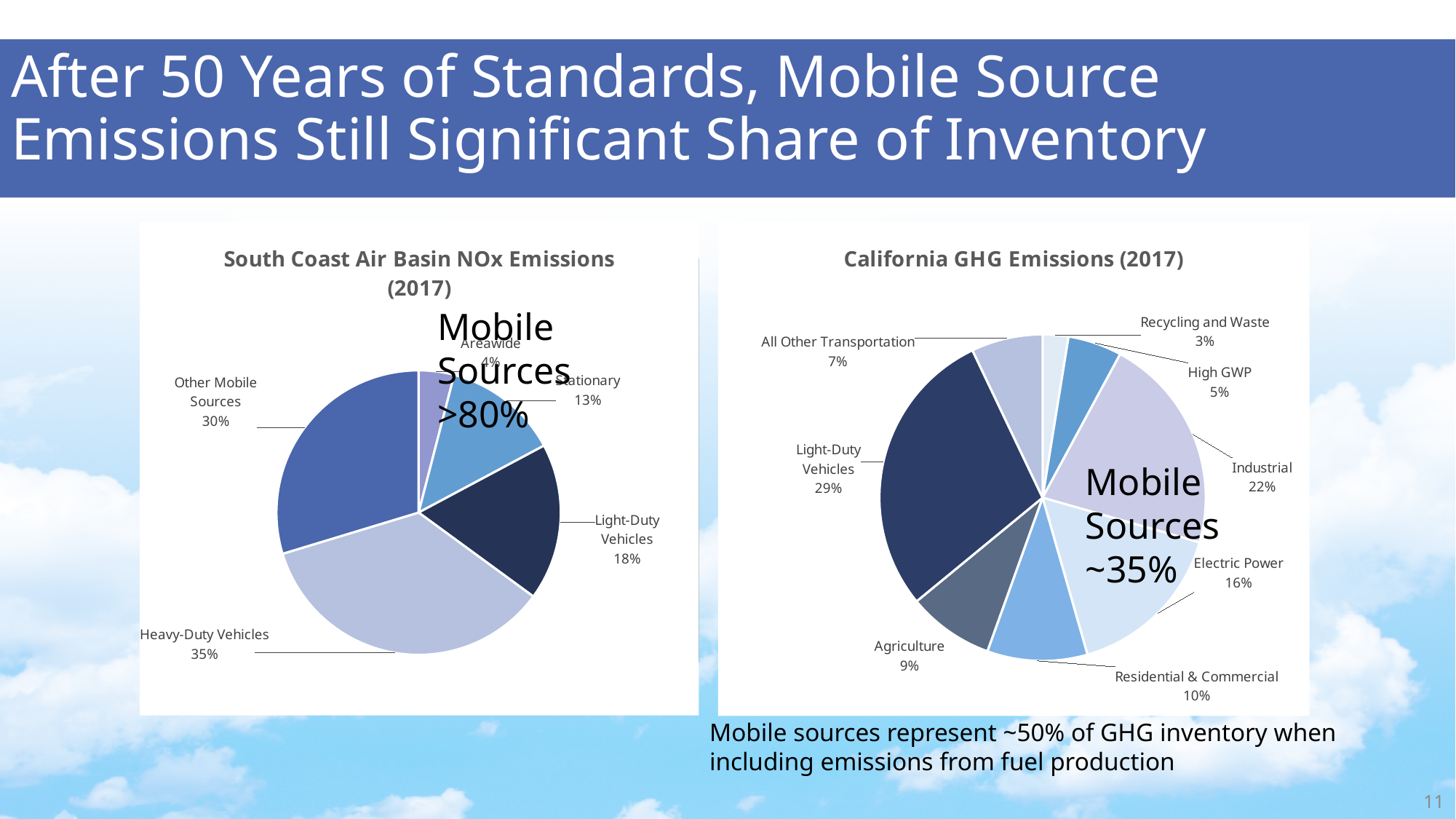
In the California GHG Emissions (2017) chart, what share do Light-Duty Vehicles account for? 29% In the California GHG Emissions (2017) chart, what is the difference between the Industrial share and the Residential & Commercial share? 12% In the California GHG Emissions (2017) chart, which category has the smallest share? Recycling and Waste In the California GHG Emissions (2017) chart, how many categories are shown? 8 In the California GHG Emissions (2017) chart, what share is attributed to Electric Power? 16% In the South Coast Air Basin NOx Emissions (2017) chart, what is the difference between the Heavy-Duty Vehicles share and the Light-Duty Vehicles share? 17% In the South Coast Air Basin NOx Emissions (2017) chart, what share do Heavy-Duty Vehicles account for? 35% In the California GHG Emissions (2017) chart, which category has the largest share? Light-Duty Vehicles What type of chart is the South Coast Air Basin NOx Emissions (2017) chart? Pie chart In the South Coast Air Basin NOx Emissions (2017) chart, which category has the largest share? Heavy-Duty Vehicles In the South Coast Air Basin NOx Emissions (2017) chart, which is larger: Other Mobile Sources or Stationary? Other Mobile Sources In the South Coast Air Basin NOx Emissions (2017) chart, what share is attributed to Stationary sources? 13%